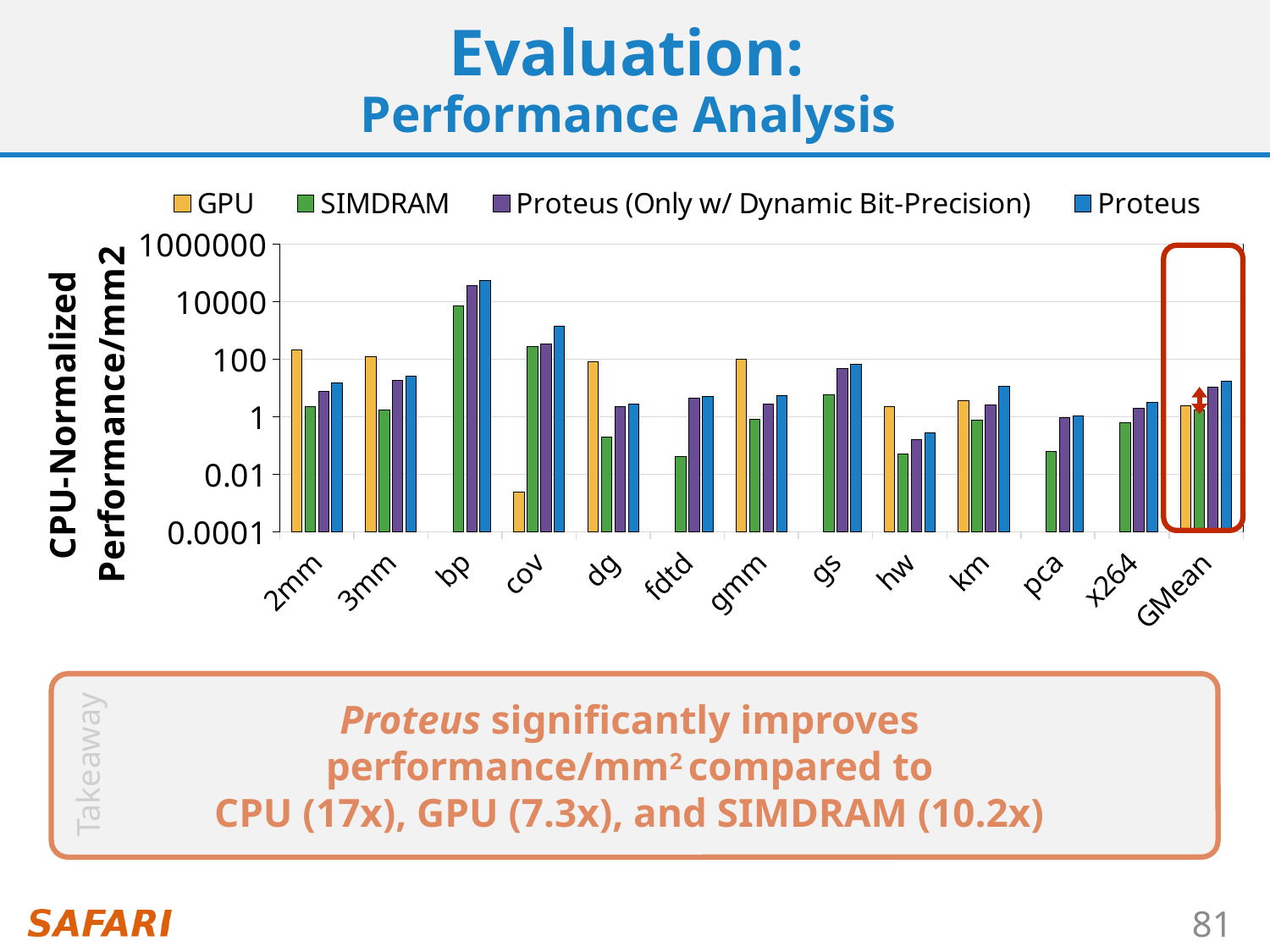
Is the Proteus value for bp greater or less than 10000? greater For which category is the GPU bar the lowest? cov For which category is the Proteus bar the highest? bp Is the SIMDRAM value for hw greater or less than 1? less Is the GPU value for cov greater or less than 0.01? less For cov, which is larger: the GPU value or the Proteus value? Proteus How many series does the legend list? 4 Which category on the x axis is highlighted with a red box? GMean What kind of chart is shown on the slide? bar chart How many categories are shown on the x axis? 13 For 2mm, which is larger: the GPU value or the SIMDRAM value? GPU